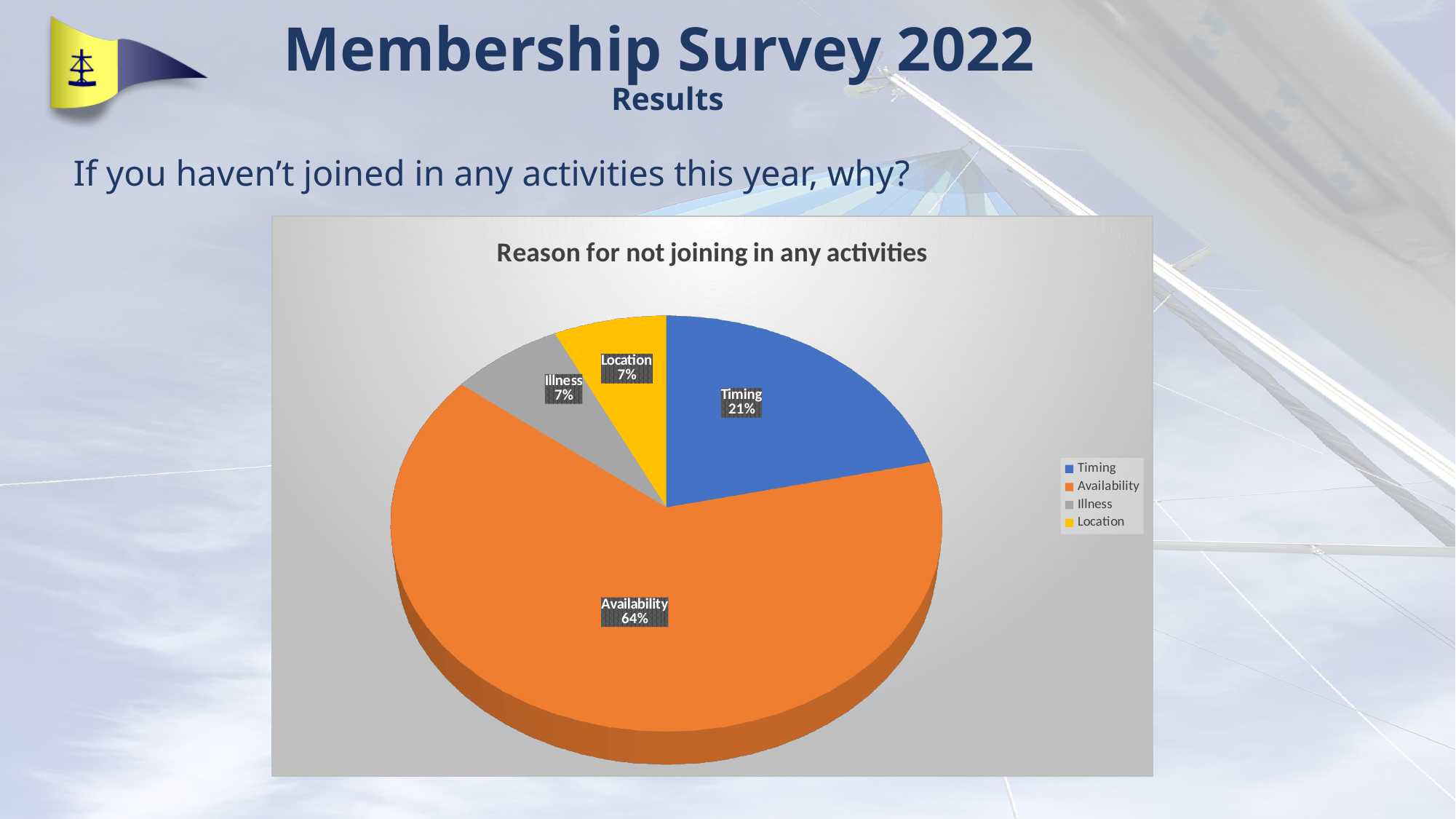
Which reason has the largest slice of the pie? Availability What percentage is shown for Location? 7% How many categories does the pie chart show? 4 Which colour represents Illness in the chart? Grey What percentage is shown for Illness? 7% What is the difference in percentage points between Availability and Timing? 43 What is the title of the chart? Reason for not joining in any activities What percentage is shown for Timing? 21% What kind of chart is shown on the slide? Pie chart Which is larger, the Timing slice or the Location slice? Timing What is the difference in percentage points between Timing and Illness? 14 What share of the pie does Availability account for? 64%